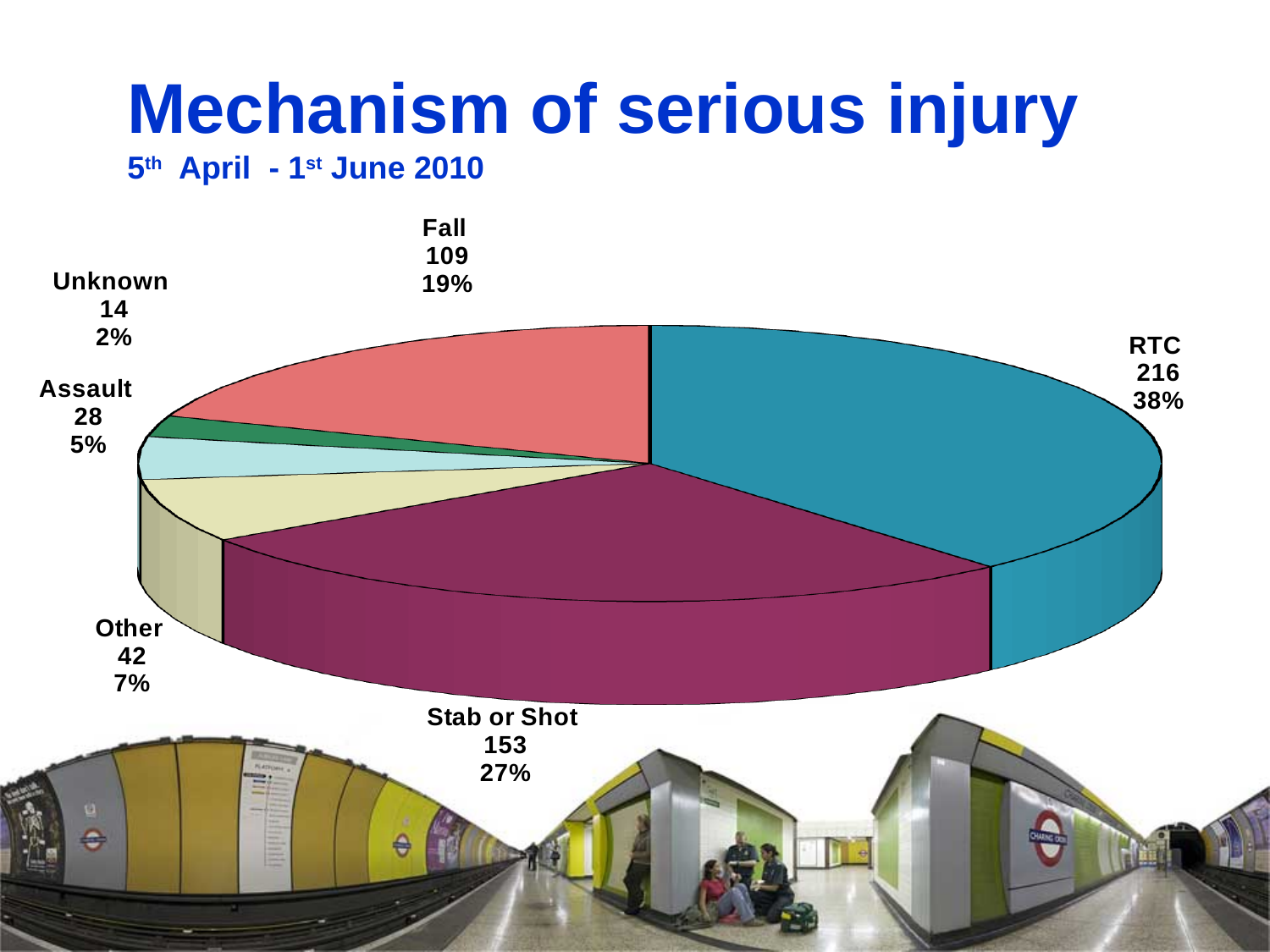
What is the total number of serious injuries across all categories in the pie chart? 562 How many serious injuries were caused by RTC? 216 How many serious injuries were caused by a Fall? 109 What is the difference between the number of RTC injuries and Stab or Shot injuries? 63 What date range does the chart cover, according to the subtitle? 5th April - 1st June 2010 Which has more serious injuries, Other or Assault? Other What share of the pie does Assault represent? 5% What percentage of serious injuries were due to Stab or Shot? 27% What type of chart is shown on the slide? Pie chart How many categories are shown in the pie chart? 6 Which mechanism of serious injury has the smallest slice of the pie? Unknown Which mechanism of serious injury has the largest slice of the pie? RTC